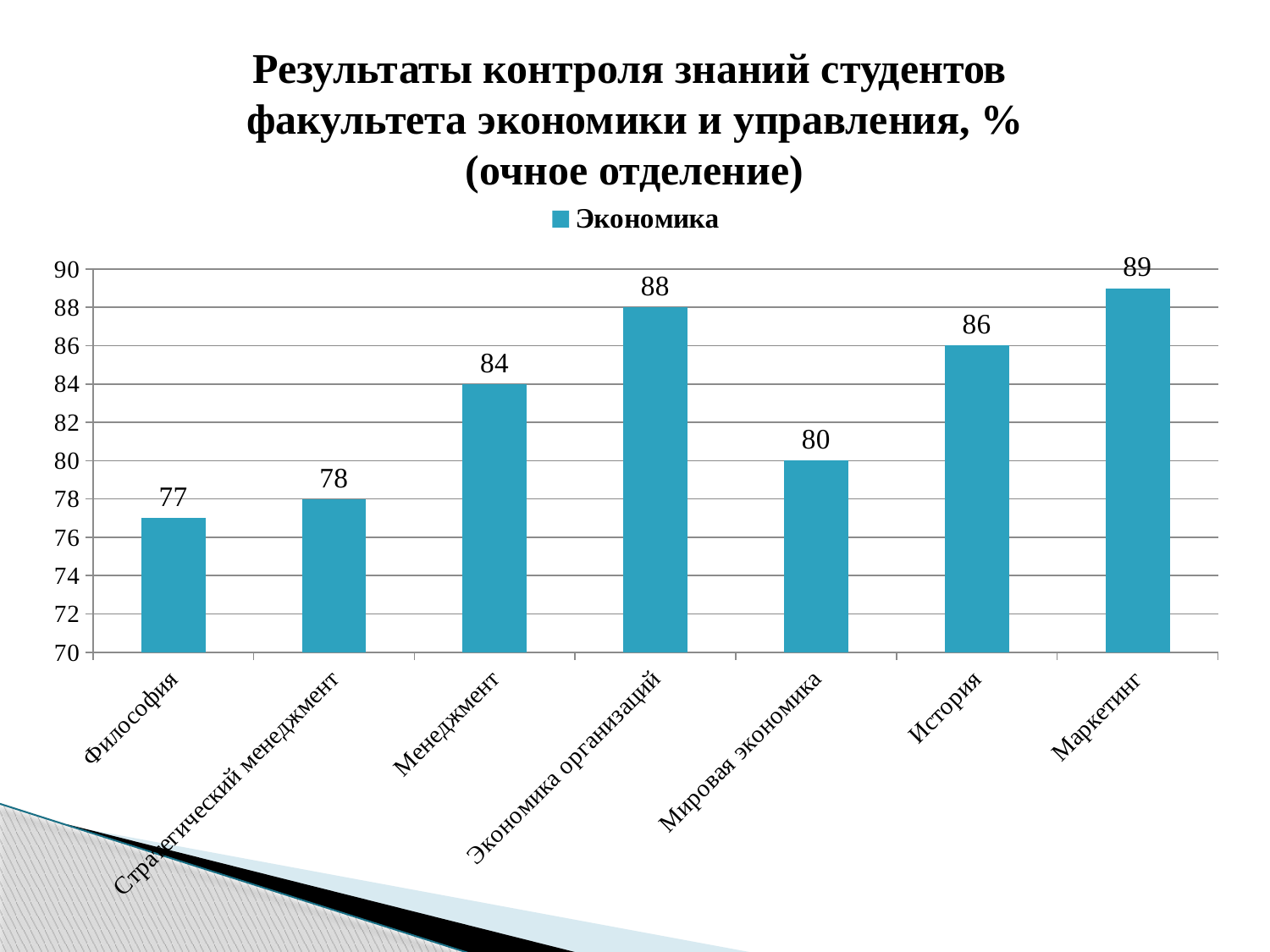
What is the value for История? 86 Which category has the highest value? Маркетинг What kind of chart is shown on the slide? bar chart Which is larger, the value for Менеджмент or the value for Мировая экономика? Менеджмент How many series does the legend list? 1 What is the value for Экономика организаций? 88 Is the value for Стратегический менеджмент greater or less than 80? less What is the difference between the values for Маркетинг and Философия? 12 Which category has the lowest value? Философия What is the difference between the values for Экономика организаций and Мировая экономика? 8 What is the value for Философия? 77 How many categories are shown on the x axis? 7